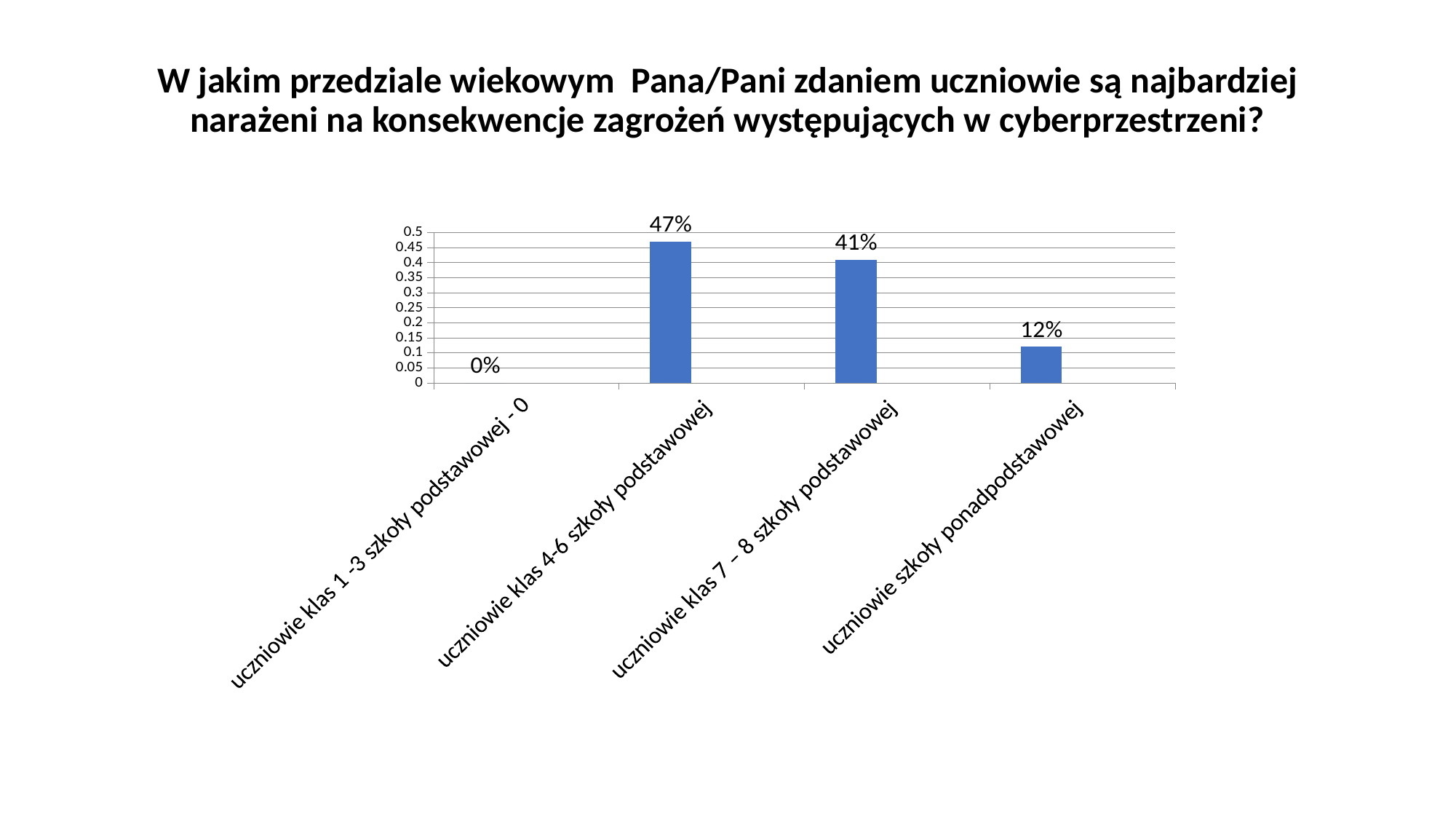
What is the value for uczniowie klas 7 – 8 szkoły podstawowej? 41% Which category has the highest value? uczniowie klas 4-6 szkoły podstawowej Which is larger: the value for uczniowie klas 7 – 8 szkoły podstawowej or uczniowie szkoły ponadpodstawowej? uczniowie klas 7 – 8 szkoły podstawowej Is the value for uczniowie szkoły ponadpodstawowej greater or less than 0.2? less What is the value for uczniowie klas 4-6 szkoły podstawowej? 47% How many categories are shown on the x axis? 4 What kind of chart is shown on the slide? bar chart What is the difference between the values for uczniowie klas 7 – 8 szkoły podstawowej and uczniowie szkoły ponadpodstawowej? 29% What is the value for uczniowie szkoły ponadpodstawowej? 12% What is the value for uczniowie klas 1 -3 szkoły podstawowej? 0% What is the difference between the values for uczniowie klas 4-6 szkoły podstawowej and uczniowie klas 7 – 8 szkoły podstawowej? 6% Which category has the lowest value? uczniowie klas 1 -3 szkoły podstawowej